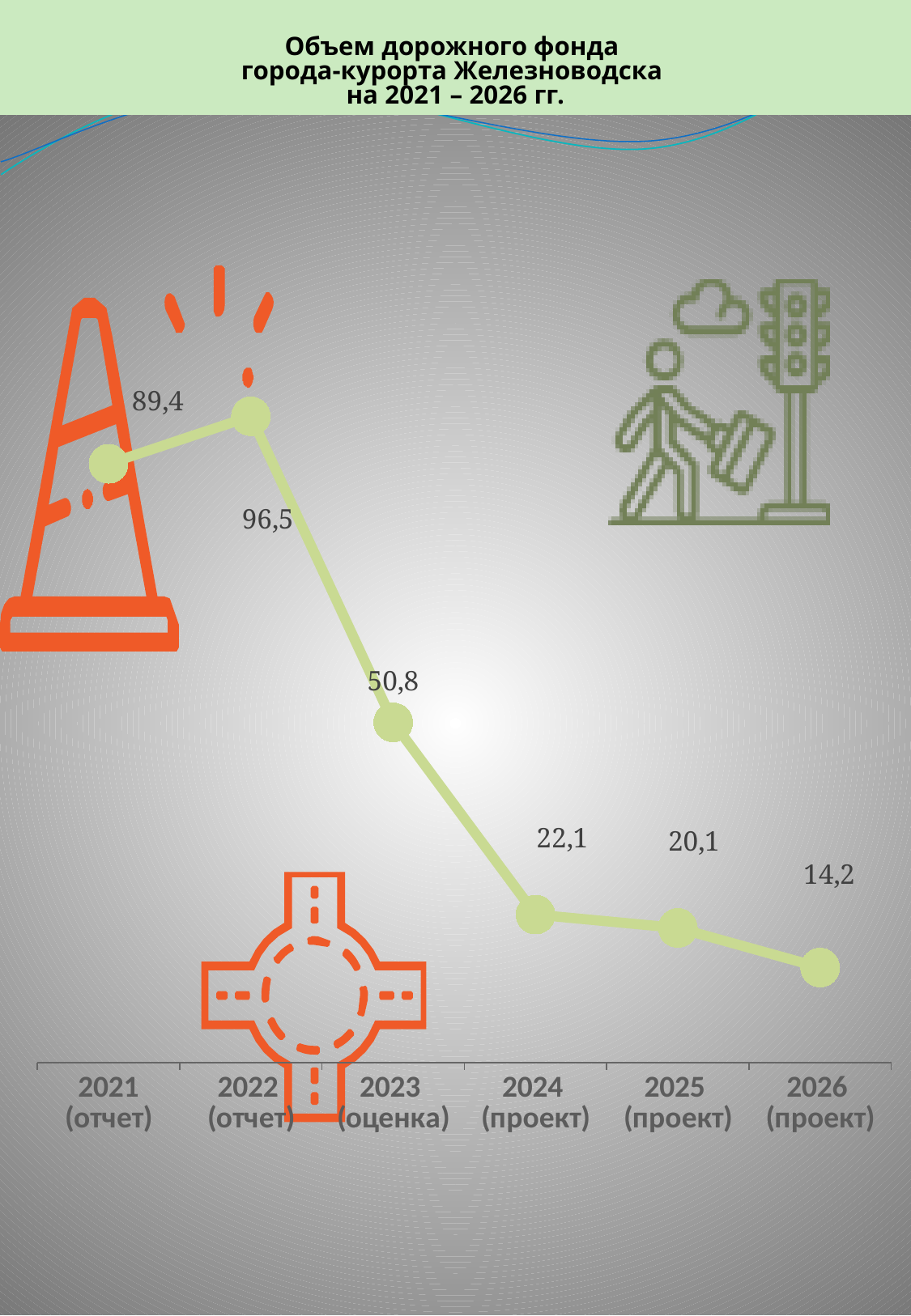
What is the value for 2022 (отчет)? 96,5 What type of chart is shown on the slide? line chart How many data points are plotted on the chart? 6 What is the value for 2021 (отчет)? 89,4 What is the difference between the values for 2022 (отчет) and 2021 (отчет)? 7,1 Which is larger, the value for 2024 (проект) or the value for 2025 (проект)? 2024 (проект) What is the value for 2023 (оценка)? 50,8 What is the difference between the values for 2023 (оценка) and 2024 (проект)? 28,7 Do the values rise or fall from 2022 to 2026? fall What is the value for 2026 (проект)? 14,2 Which year has the lowest value? 2026 (проект) Which year has the highest value? 2022 (отчет)